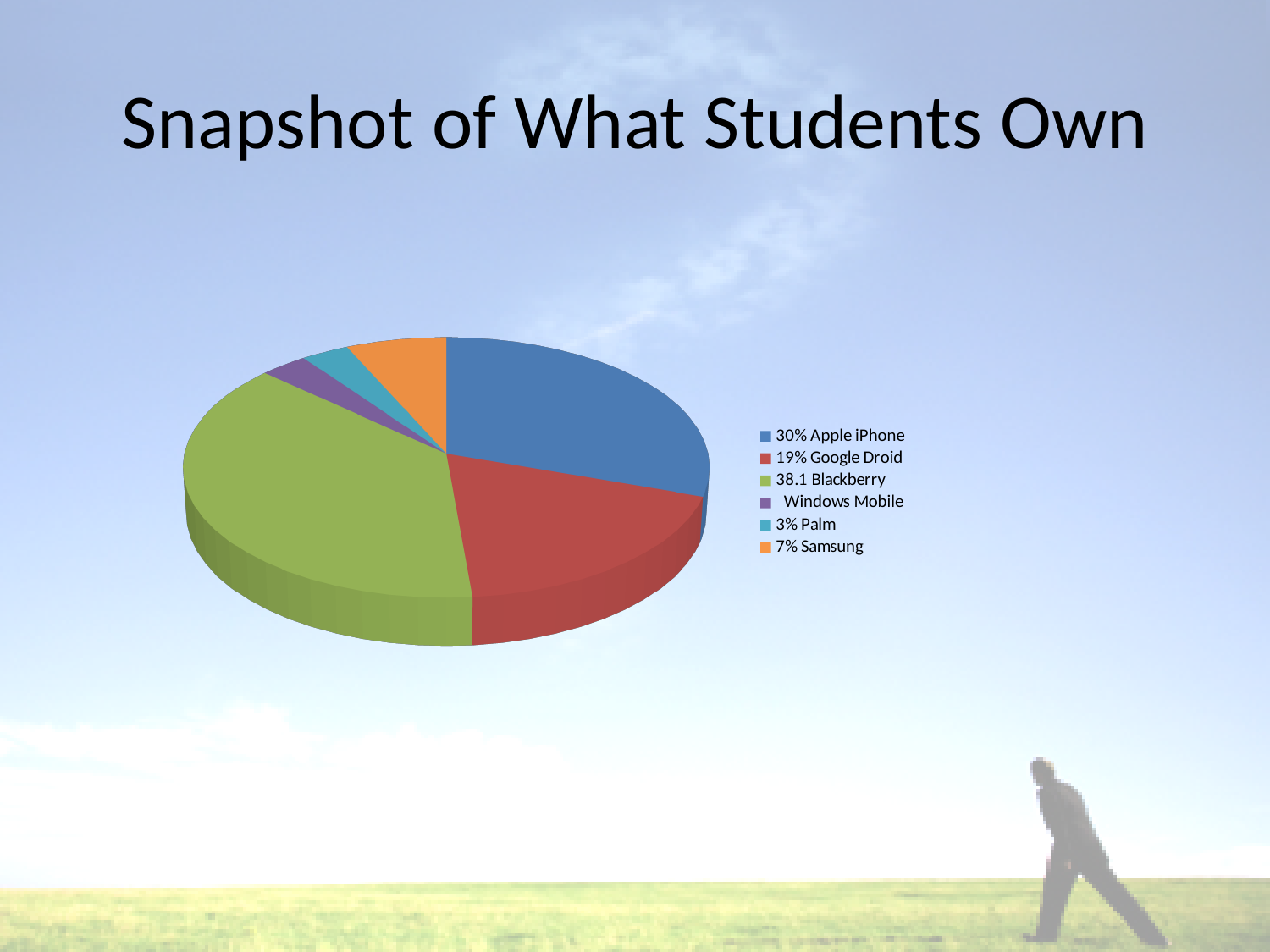
What value is shown for Blackberry in the legend? 38.1 Which category has the largest slice of the pie? Blackberry Which slice is larger, Apple iPhone or Google Droid? Apple iPhone What percentage is shown for Palm in the legend? 3% What is the title of the slide containing the pie chart? Snapshot of What Students Own Which slice is larger, Samsung or Palm? Samsung How many categories does the pie chart's legend list? 6 What percentage is shown for Apple iPhone in the legend? 30% What is the difference between the Apple iPhone and Google Droid percentages? 11% What share of the pie does Samsung have? 7% What percentage is shown for Google Droid in the legend? 19% What kind of chart is shown on the slide? pie chart